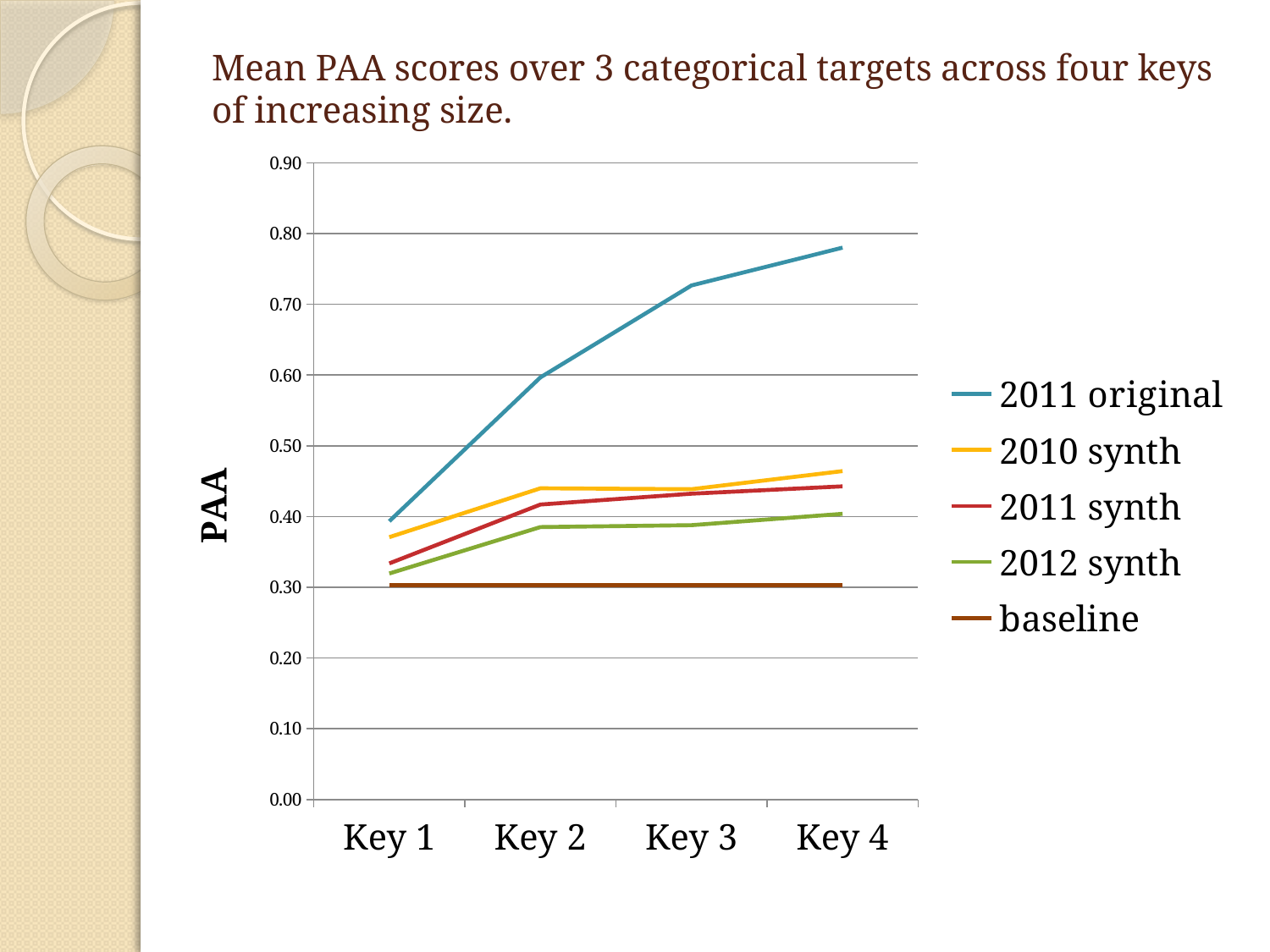
Is the value for 2012 synth at Key 4 greater or less than 0.50? less Does the baseline series rise, fall, or stay flat across the four keys? stay flat Is the value for 2011 original at Key 1 greater or less than 0.50? less Which series has the lowest value at Key 1? baseline What kind of chart is shown on the slide? line chart Which series has the highest value at Key 4? 2011 original How many keys are shown along the x axis? 4 What is the label on the y axis? PAA Does the 2011 original series rise or fall from Key 1 to Key 4? rise At Key 2, which is larger: 2011 original or 2010 synth? 2011 original How many series does the legend list? 5 Is the value for 2011 original at Key 4 greater or less than 0.70? greater